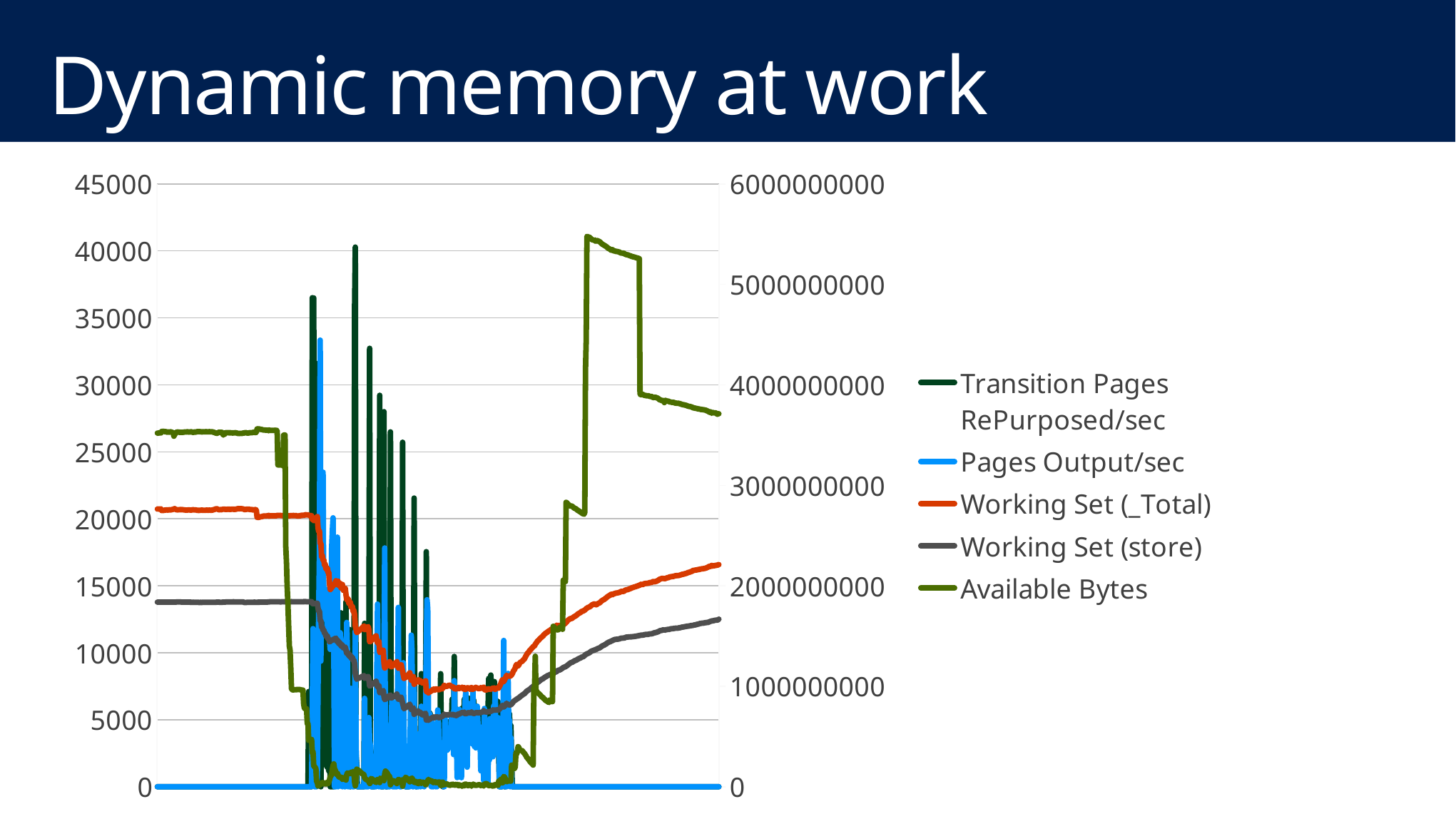
Is the peak of the Available Bytes line greater or less than 5000000000 on the right axis? greater What is the highest tick value shown on the left vertical axis? 45000 Is the highest spike of the Transition Pages RePurposed/sec line greater or less than 35000 on the left axis? greater In the left-hand portion of the chart, does the Available Bytes line rise or fall after its initial flat section? fall In the right-hand portion of the chart, does the Working Set (_Total) line rise or fall as it moves to the right? rise Is the highest spike of the Pages Output/sec line greater or less than 30000 on the left axis? greater What kind of chart is shown on the slide? line chart How many series does the legend list? 5 At the right end of the chart, which is higher: Working Set (_Total) or Working Set (store)? Working Set (_Total) Which series has the highest spike on the chart? Transition Pages RePurposed/sec Which series is drawn in blue? Pages Output/sec